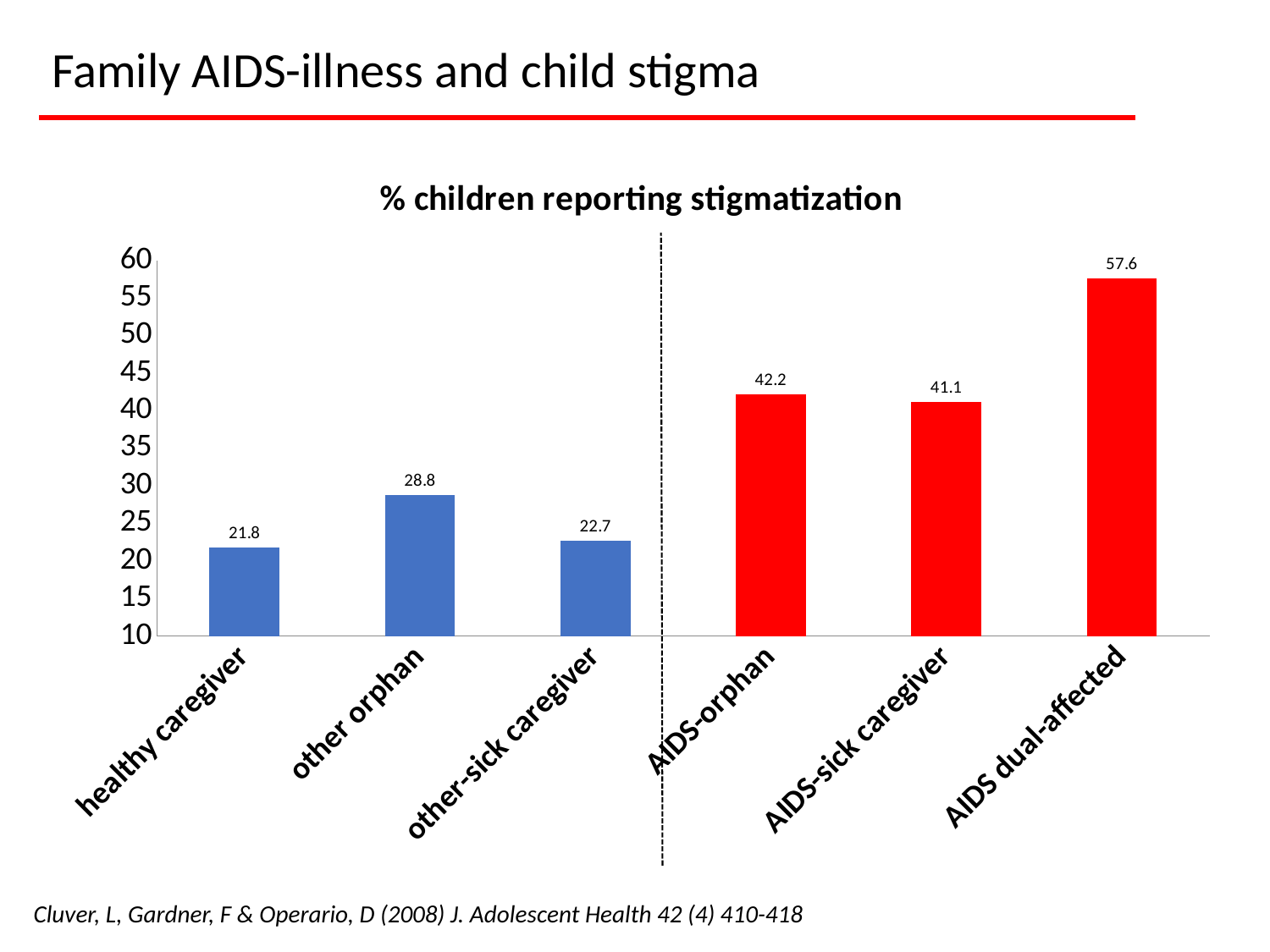
What is the value for AIDS-sick caregiver? 41.1 Which category has the lowest value? healthy caregiver What is the difference between the values for AIDS dual-affected and healthy caregiver? 35.8 Is the value for AIDS-orphan greater or less than 40? greater What is the value for AIDS dual-affected? 57.6 What is the difference between the values for AIDS-orphan and other orphan? 13.4 What is the value for healthy caregiver? 21.8 What is the title of the chart? % children reporting stigmatization How many categories are shown on the x axis? 6 Which is larger, the value for other orphan or the value for other-sick caregiver? other orphan Which category has the highest value? AIDS dual-affected What is the value for other orphan? 28.8